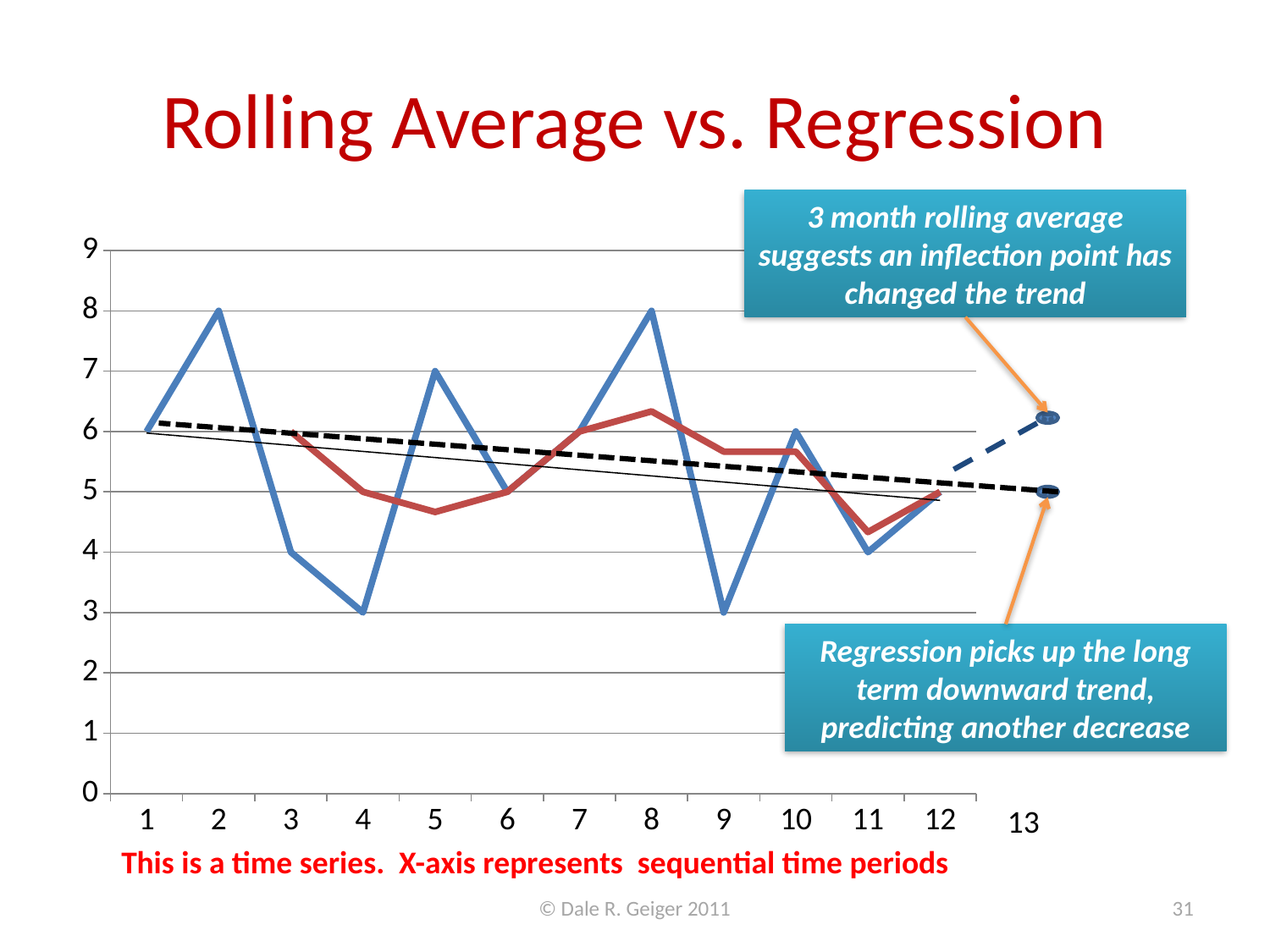
Does the dashed regression line rise or fall from left to right? fall Is the red rolling average line at time period 5 greater or less than 5? less What is the value of the blue line at time period 12? 5 What is the value of the blue line at time period 4? 3 At which time periods does the blue line reach its highest value? 2 and 8 What type of chart is shown on the slide? line chart What is the title of the slide containing the chart? Rolling Average vs. Regression How many time periods are labeled on the x-axis of the chart? 13 What is the difference between the blue line's values at time periods 8 and 9? 5 Is the blue line's value at time period 5 larger than its value at time period 6? Yes What is the value of the blue line at time period 2? 8 What is the value of the blue line at time period 9? 3